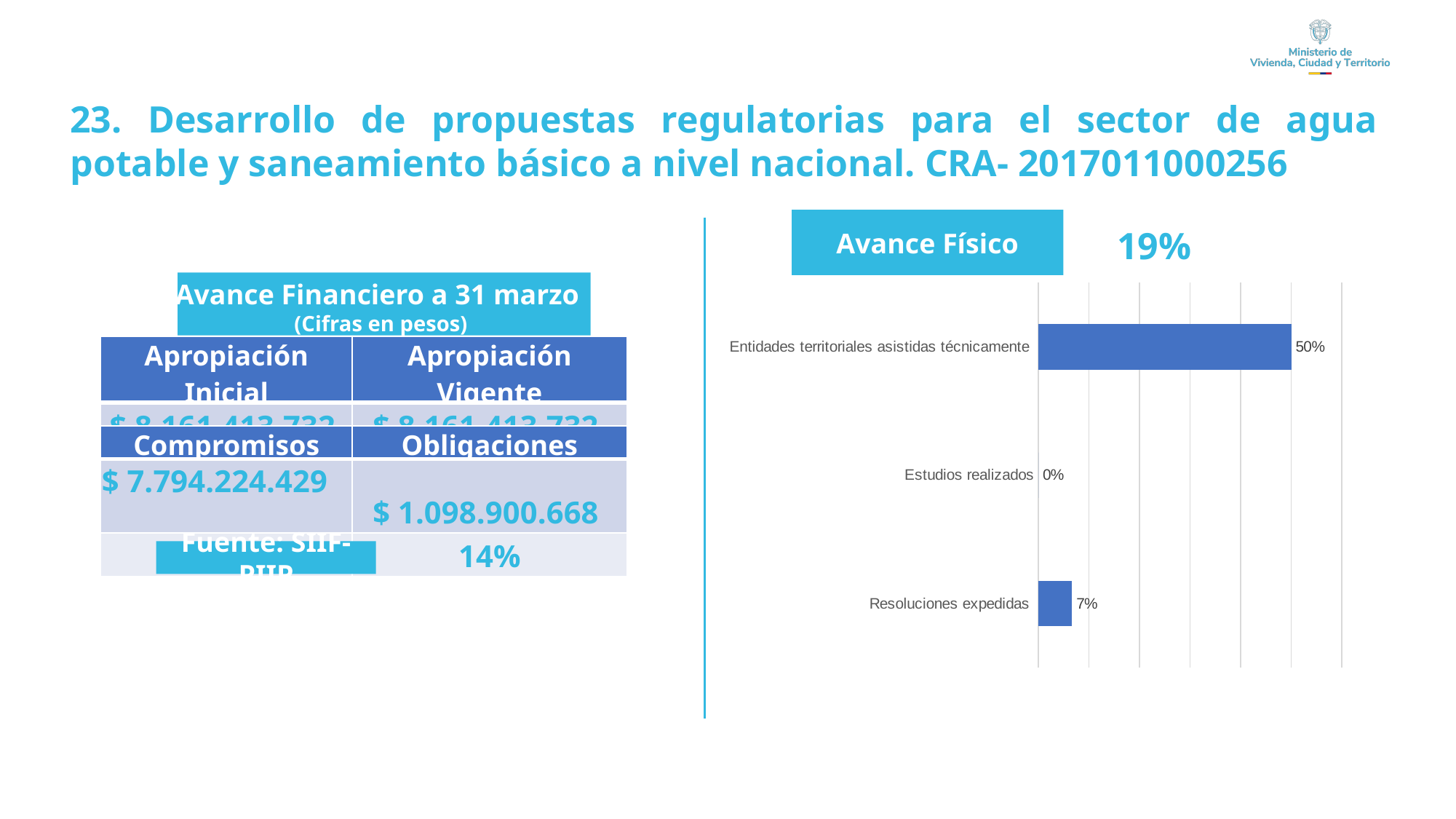
What is the title of the chart? Avance Físico Which category has the lowest value? Estudios realizados What is the value for Estudios realizados? 0% Which category has the highest value? Entidades territoriales asistidas técnicamente Which is larger, the value for Resoluciones expedidas or the value for Estudios realizados? Resoluciones expedidas What is the value for Resoluciones expedidas? 7% What is the difference between the values for Entidades territoriales asistidas técnicamente and Resoluciones expedidas? 43% Which is larger, the value for Entidades territoriales asistidas técnicamente or the value for Resoluciones expedidas? Entidades territoriales asistidas técnicamente What is the value for Entidades territoriales asistidas técnicamente? 50% What is the difference between the values for Resoluciones expedidas and Estudios realizados? 7% How many categories are shown in the chart? 3 What kind of chart is shown on the slide? Bar chart